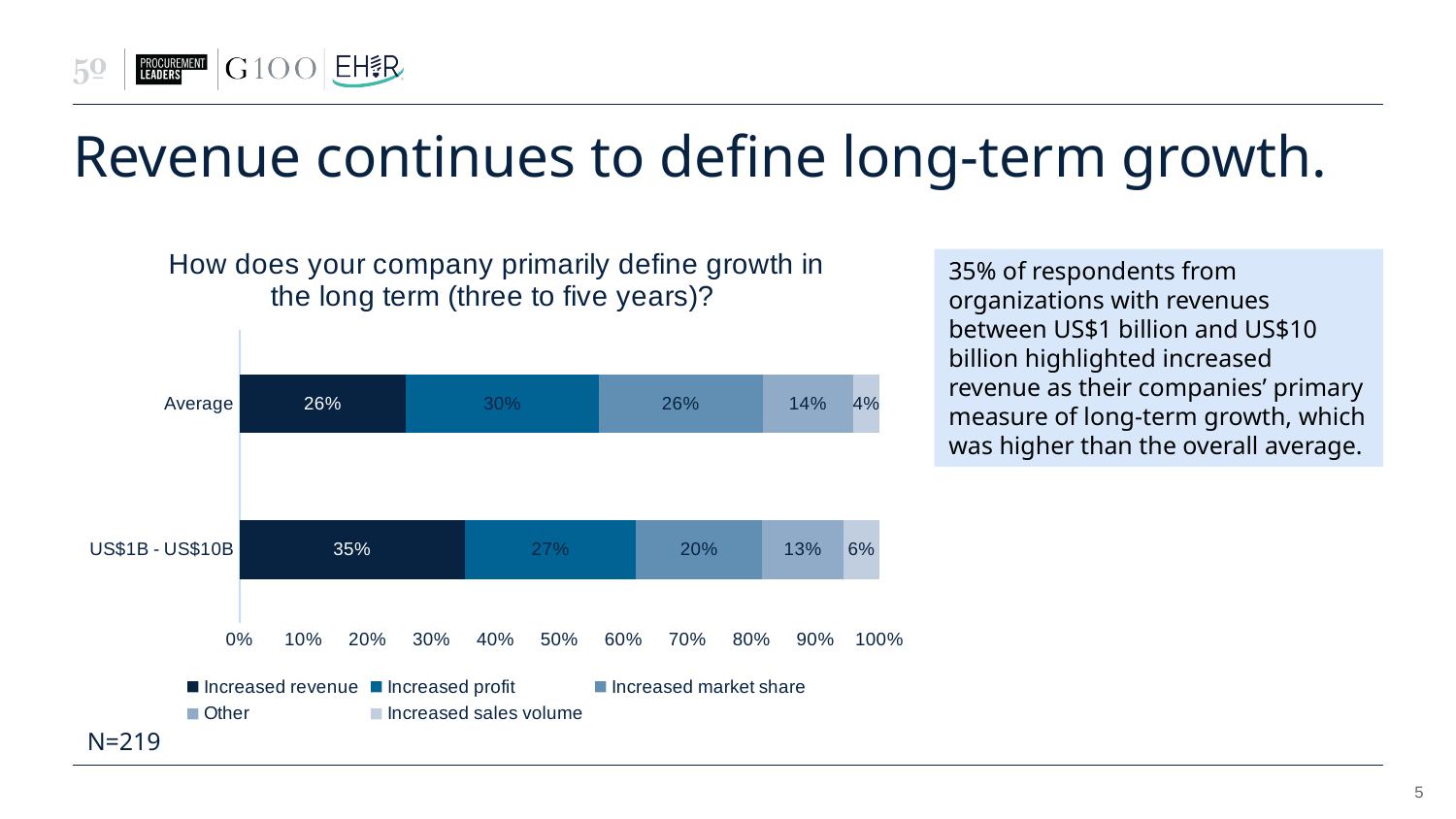
How many series does the legend list? 5 What kind of chart is shown on the slide? Stacked bar chart What is the value for Increased market share in the US$1B - US$10B bar? 20% What is the difference between the Increased revenue value for US$1B - US$10B and the Average Increased revenue value? 9% Which series has the largest share in the Average bar? Increased profit What percentage of respondents in the US$1B - US$10B group chose Increased revenue? 35% What is the Average value for Increased profit? 30% How many categories (bars) are shown on the chart? 2 Which is larger: the Increased market share value for Average or for US$1B - US$10B? Average Which series has the smallest share in the US$1B - US$10B bar? Increased sales volume What is the value for Other in the US$1B - US$10B bar? 13% What is the Average value for Increased sales volume? 4%